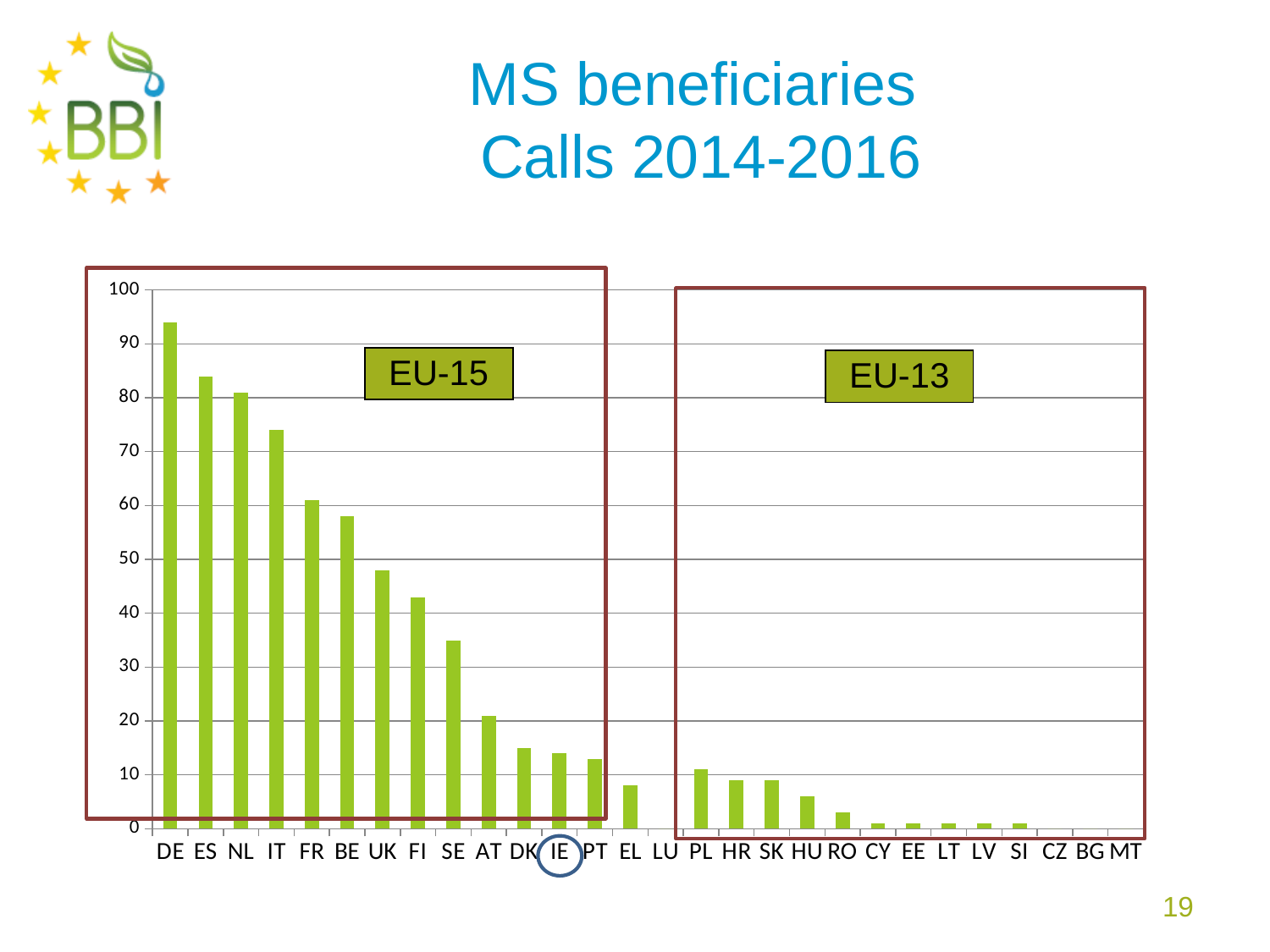
Which has a larger value, UK or FI? UK How many countries are shown on the x axis of the chart? 28 Is the value for DE greater or less than 90? greater Is the value for SE greater or less than 30? greater Which country has the highest value in the chart? DE Is the value for UK greater or less than 50? less Which country label on the x axis is circled? IE What kind of chart is shown on the slide? bar chart Which has a larger value, PL or HU? PL